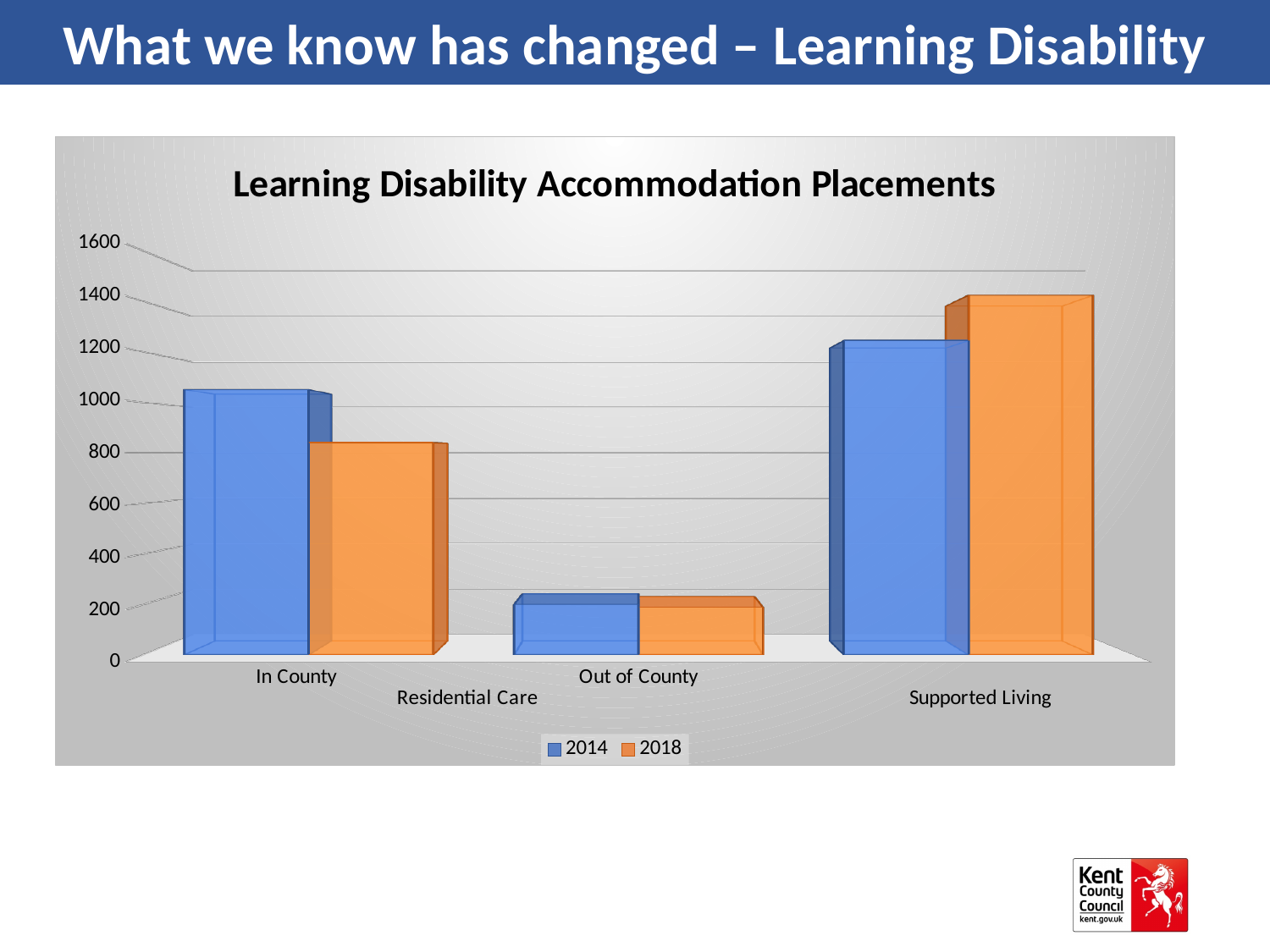
Which category has the highest value for 2018? Supported Living How many categories are shown along the x axis? 3 Is the 2018 value for In County greater or less than 1000? less How many series does the legend list? 2 What is the title of the chart? Learning Disability Accommodation Placements What kind of chart is shown on the slide? Bar chart Is the 2014 value for Out of County greater or less than 400? less Is the 2018 value for Supported Living greater or less than 1200? greater Which category has the lowest value for 2014? Out of County For In County, which year has the larger value, 2014 or 2018? 2014 Which colour represents the 2018 series in the legend? Orange For Supported Living, which year has the larger value, 2014 or 2018? 2018